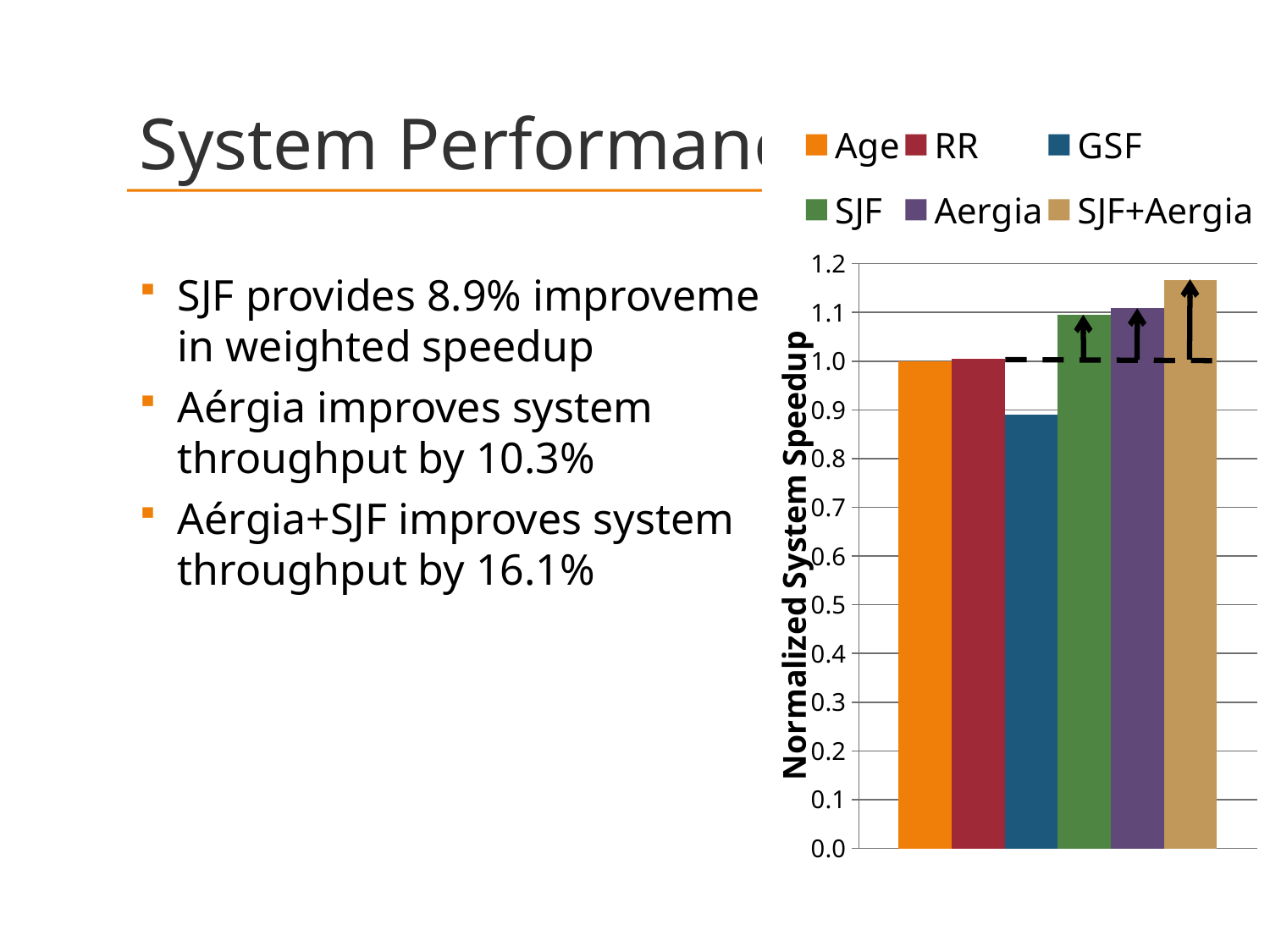
Is the normalized system speedup for SJF greater or less than 1.0? greater Is the normalized system speedup for SJF+Aergia greater or less than 1.1? greater Is the normalized system speedup for GSF greater or less than 0.8? greater What is the label of the chart's vertical axis? Normalized System Speedup Which series is shown in orange in the chart's legend? Age Which series has the highest normalized system speedup? SJF+Aergia Which has a larger normalized system speedup, GSF or SJF? SJF How many series does the chart's legend list? 6 Which has a larger normalized system speedup, Age or SJF+Aergia? SJF+Aergia Which series has the lowest normalized system speedup? GSF What kind of chart is shown on the slide? bar chart